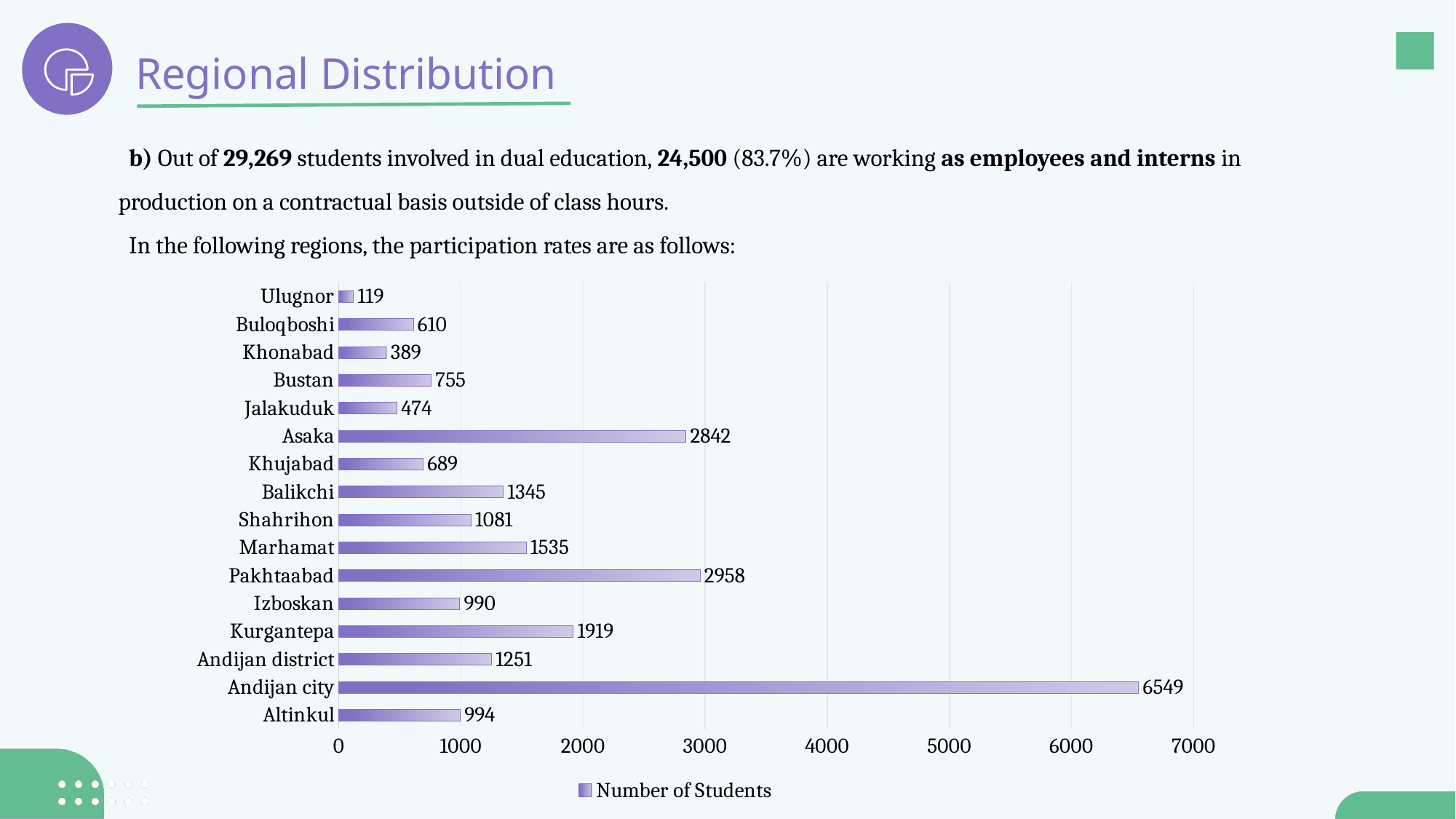
What is the number of students for Khonabad? 389 Is the value for Izboskan greater or less than 1000? less What kind of chart is shown on the slide? Bar chart What is the number of students for Asaka? 2842 How many regions are shown in the chart? 16 Which region has the lowest number of students? Ulugnor Which region has the highest number of students? Andijan city What is the difference in number of students between Pakhtaabad and Asaka? 116 Which has more students, Marhamat or Balikchi? Marhamat What is the number of students for Kurgantepa? 1919 What is the difference in number of students between Andijan city and Andijan district? 5298 What series name is listed in the chart legend? Number of Students